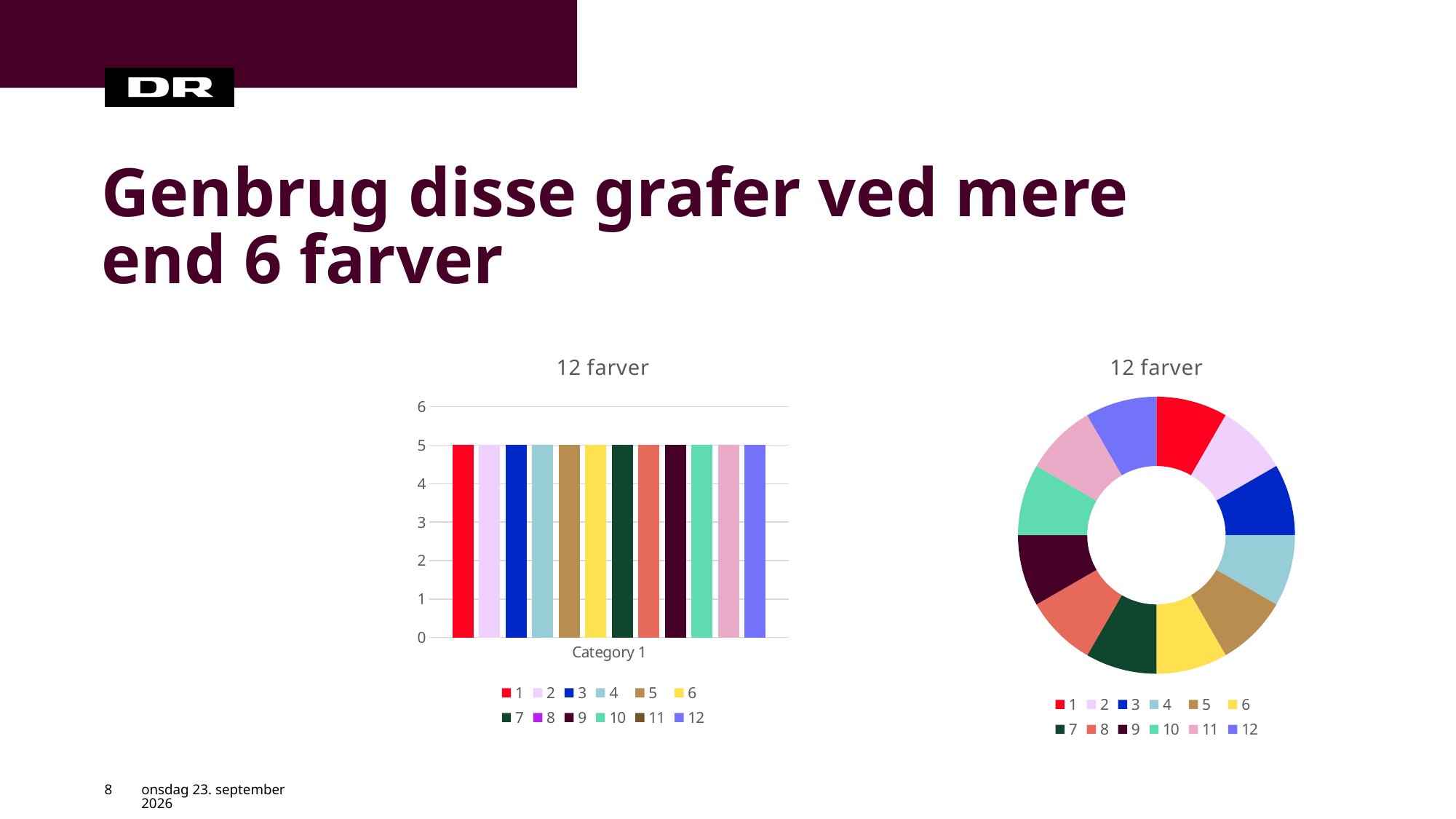
What is the title of the bar chart on the left? 12 farver What kind of chart is the chart on the right of the slide? doughnut chart In the bar chart on the left, is the value for series 3 greater or less than 4? greater What is the category label on the x axis of the bar chart on the left? Category 1 How many series does the legend of the bar chart on the left list? 12 In the bar chart on the left, what is the value of series 1 for Category 1? 5 In the bar chart on the left, what is the value of series 7 for Category 1? 5 How many entries does the legend of the doughnut chart on the right list? 12 What kind of chart is the chart on the left of the slide? bar chart How many categories are shown on the x axis of the bar chart on the left? 1 In the bar chart on the left, what is the value of series 12 for Category 1? 5 How many slices does the doughnut chart on the right have? 12